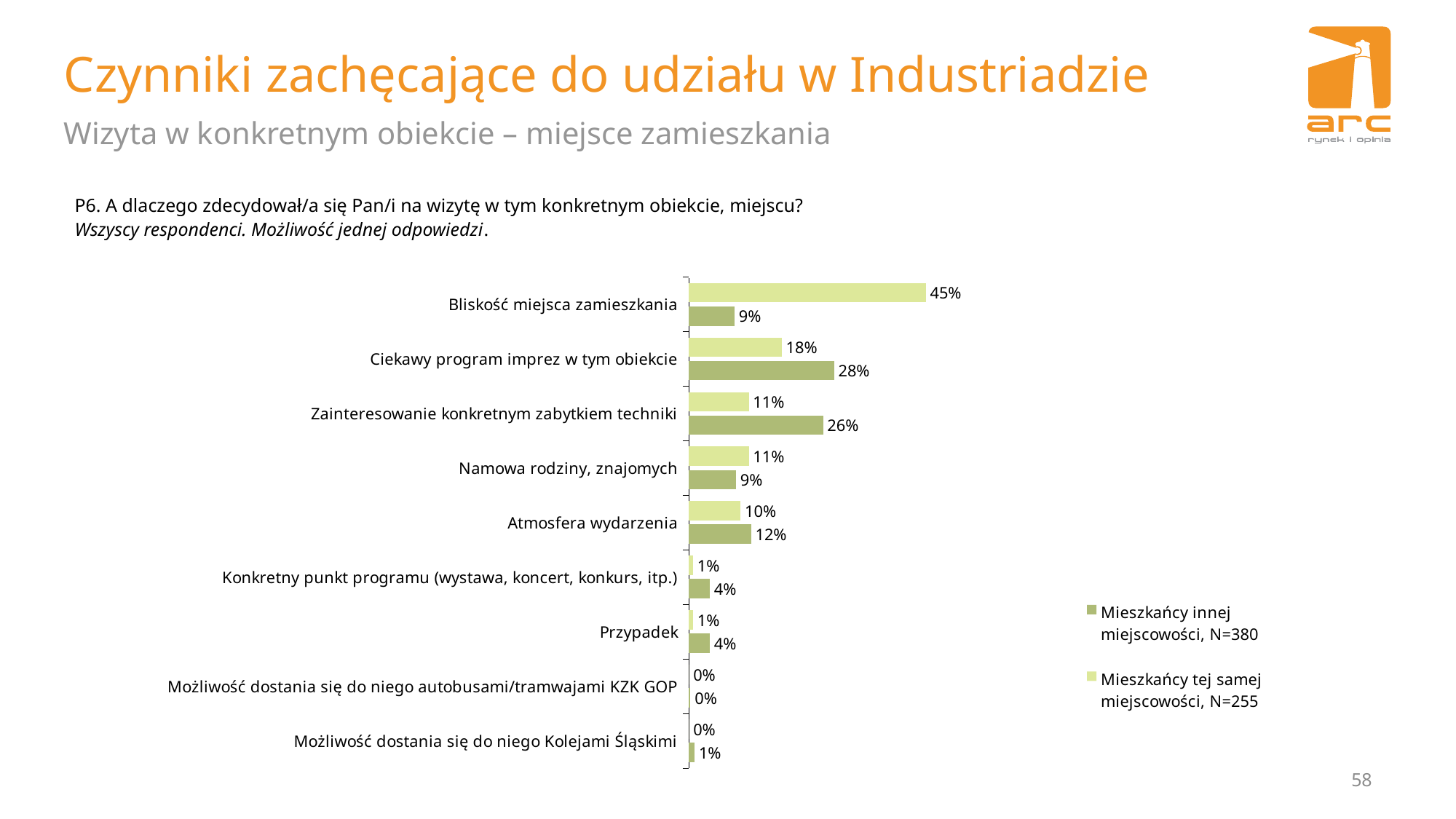
What percentage of 'Mieszkańcy tej samej miejscowości' chose 'Bliskość miejsca zamieszkania'? 45% What kind of chart is shown on the slide? Bar chart For 'Atmosfera wydarzenia', which group has the larger value: 'Mieszkańcy innej miejscowości' or 'Mieszkańcy tej samej miejscowości'? Mieszkańcy innej miejscowości How many series does the legend list? 2 For 'Namowa rodziny, znajomych', which group has the larger value? Mieszkańcy tej samej miejscowości How many categories are shown on the chart? 9 What is the value for 'Zainteresowanie konkretnym zabytkiem techniki' among 'Mieszkańcy innej miejscowości'? 26% Which category has the highest value for 'Mieszkańcy tej samej miejscowości'? Bliskość miejsca zamieszkania Which category has the highest value for 'Mieszkańcy innej miejscowości'? Ciekawy program imprez w tym obiekcie What is the difference between 'Mieszkańcy innej miejscowości' and 'Mieszkańcy tej samej miejscowości' for 'Zainteresowanie konkretnym zabytkiem techniki'? 15 percentage points What percentage of 'Mieszkańcy innej miejscowości' chose 'Ciekawy program imprez w tym obiekcie'? 28% What is the difference between the two series for 'Bliskość miejsca zamieszkania'? 36 percentage points